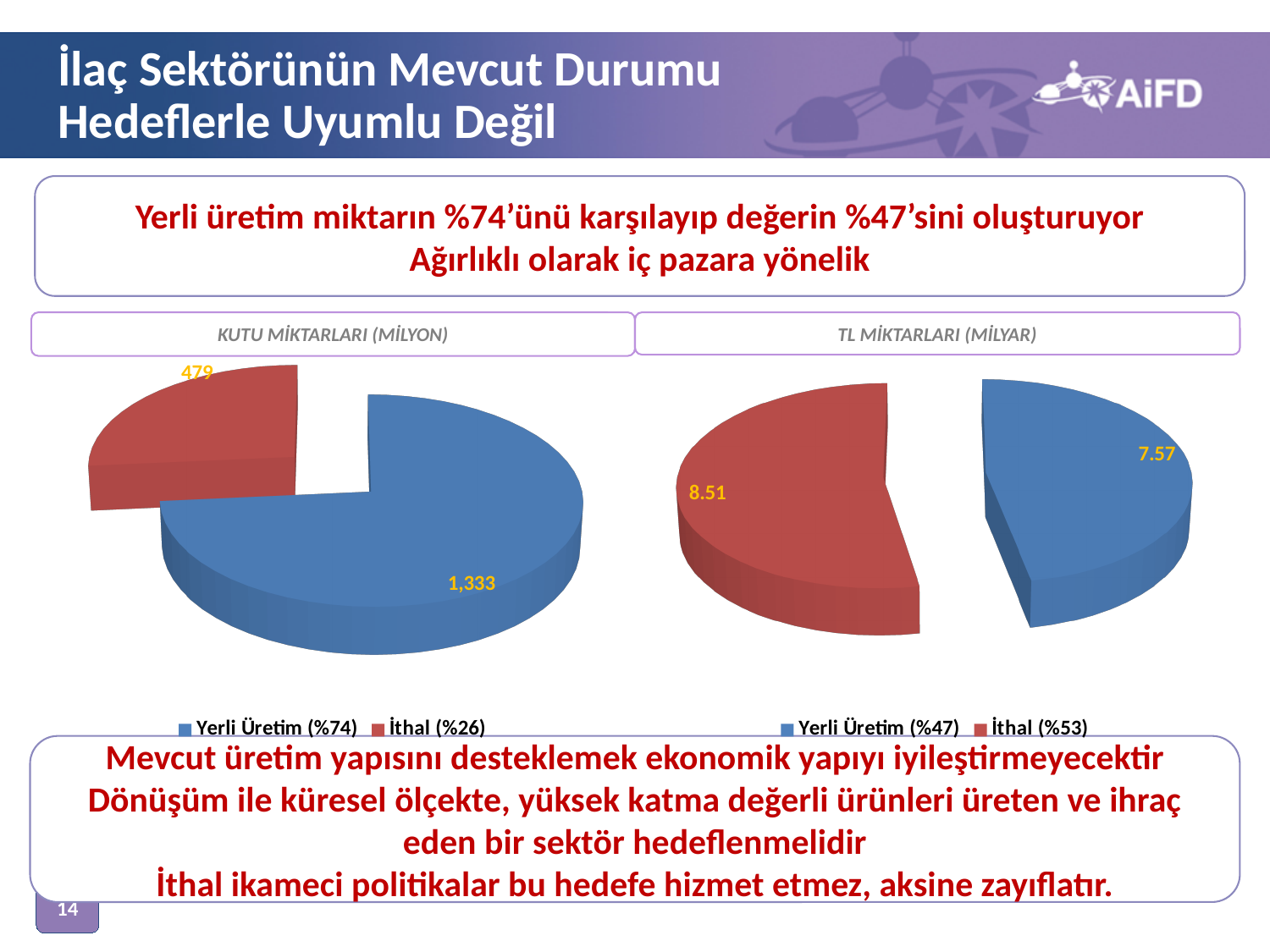
In the KUTU MİKTARLARI (MİLYON) chart, what is the difference between Yerli Üretim and İthal? 854 What type of chart is the KUTU MİKTARLARI (MİLYON) chart? Pie chart In the TL MİKTARLARI (MİLYAR) chart, which category has the smallest slice? Yerli Üretim In the KUTU MİKTARLARI (MİLYON) chart, which category has the largest slice? Yerli Üretim In the TL MİKTARLARI (MİLYAR) chart, what is the value for İthal? 8.51 In the KUTU MİKTARLARI (MİLYON) chart, what is the value for Yerli Üretim? 1,333 In the TL MİKTARLARI (MİLYAR) chart, what is the value for Yerli Üretim? 7.57 In the KUTU MİKTARLARI (MİLYON) chart, what is the value for İthal? 479 In the KUTU MİKTARLARI (MİLYON) chart, what share of the pie does İthal represent according to the legend? %26 In the TL MİKTARLARI (MİLYAR) chart, what share of the pie does Yerli Üretim represent according to the legend? %47 In the TL MİKTARLARI (MİLYAR) chart, which is larger, Yerli Üretim or İthal? İthal In the TL MİKTARLARI (MİLYAR) chart, what is the difference between İthal and Yerli Üretim? 0.94